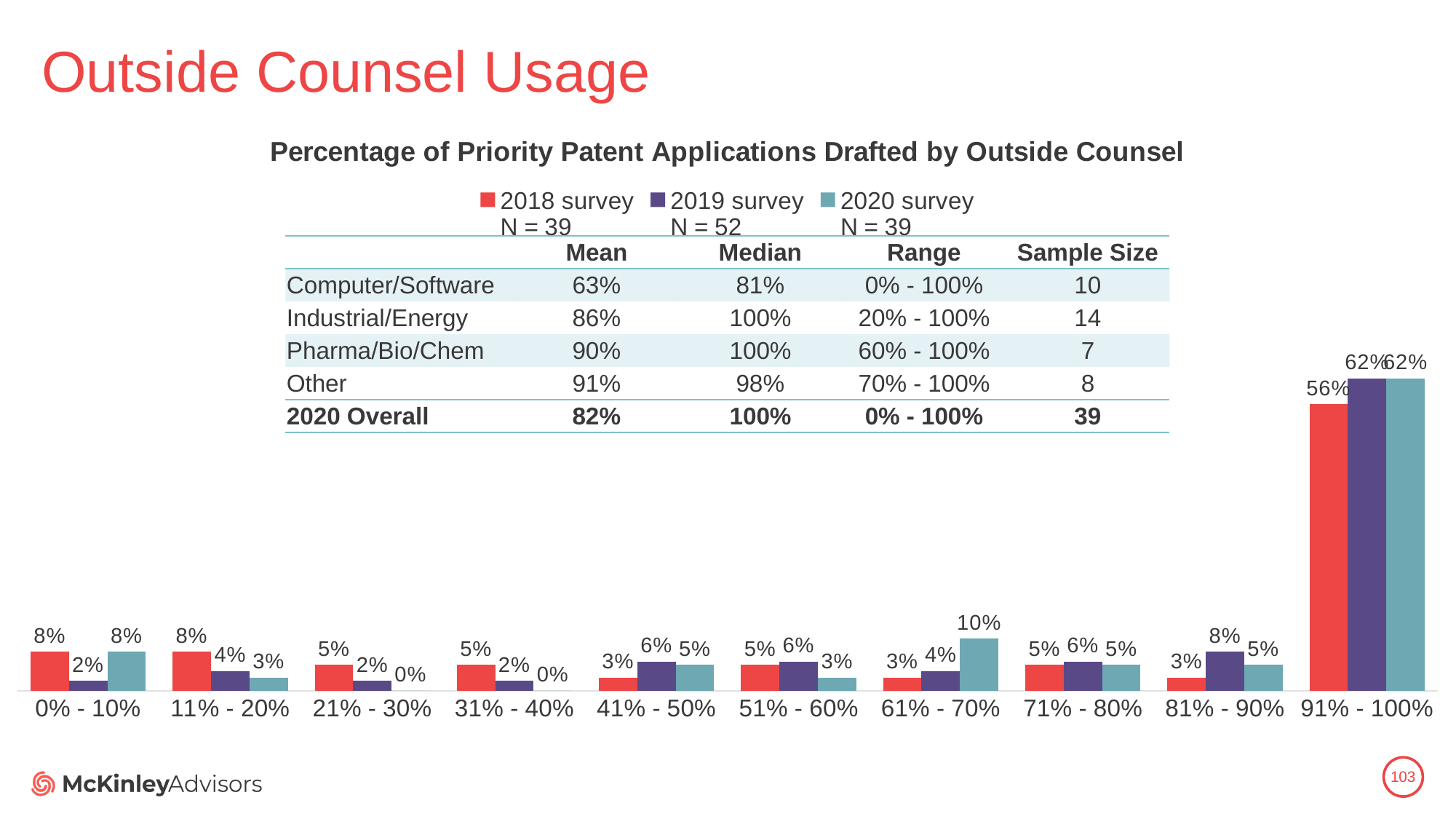
How many categories are shown on the x axis of the chart? 10 What is the 2020 survey value for the 61% - 70% category? 10% Which category has the highest value for the 2019 survey? 91% - 100% What is the 2019 survey value for the 0% - 10% category? 2% What is the 2020 survey value for the 91% - 100% category? 62% What is the difference between the 2019 survey and 2018 survey values for the 91% - 100% category? 6% What is the 2020 survey value for the 21% - 30% category? 0% What is the sample size (N) for the 2019 survey shown in the legend? 52 What kind of chart is shown on the slide? bar chart What is the 2018 survey value for the 91% - 100% category? 56% For the 81% - 90% category, which is larger: the 2019 survey value or the 2018 survey value? 2019 survey How many series does the chart legend list? 3